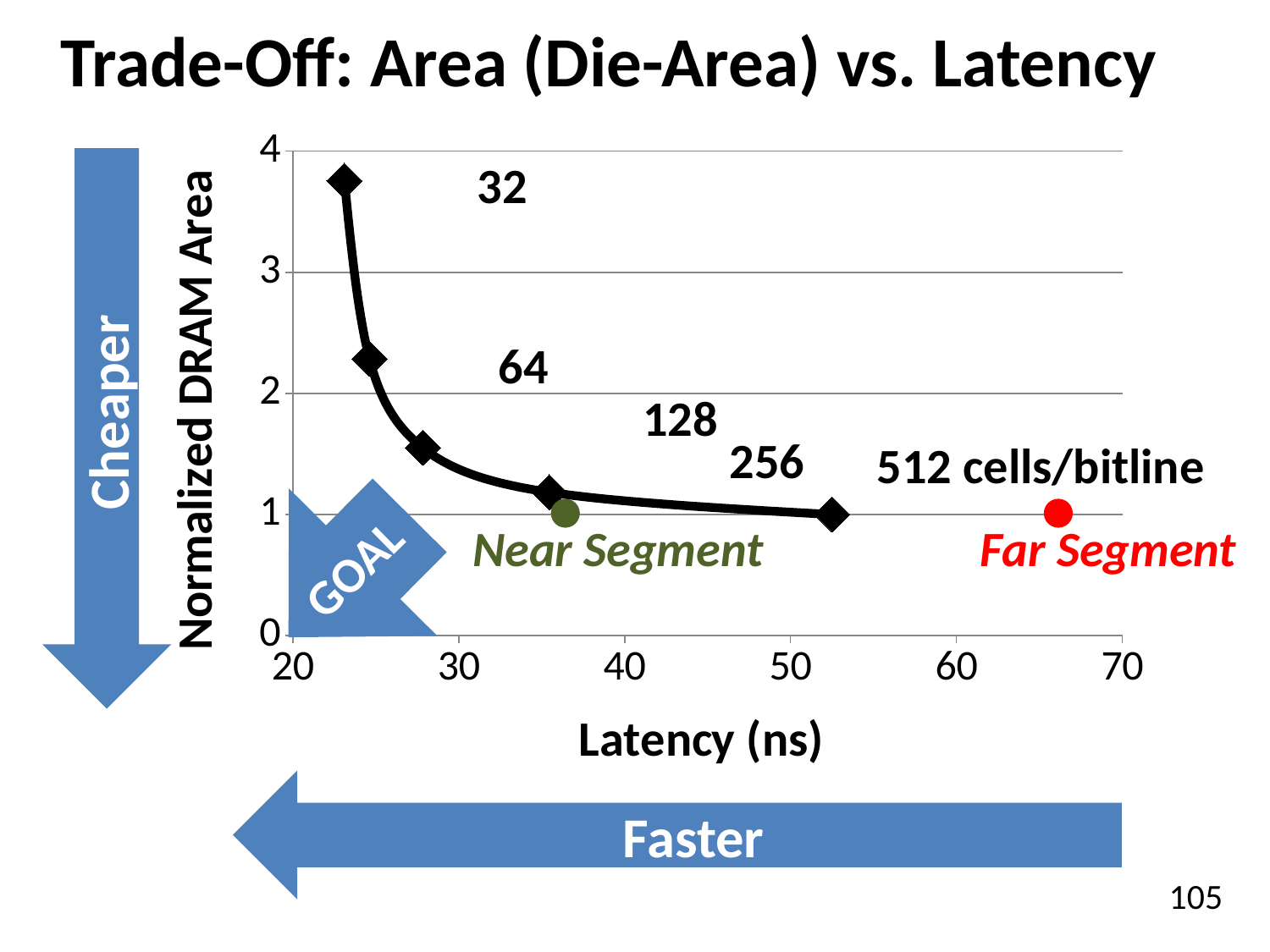
Is the normalized DRAM area for 128 cells/bitline greater or less than 2? less Is the normalized DRAM area for 32 cells/bitline greater or less than 3? greater Is the normalized DRAM area for 64 cells/bitline greater or less than 2? greater How many black diamond data points are plotted on the curve? 5 What kind of chart is shown on the slide? line chart Which cells/bitline configuration has the highest normalized DRAM area? 32 Which cells/bitline configuration has the lowest latency? 32 As latency increases along the x axis, does the normalized DRAM area rise or fall? fall What is the title of the x axis? Latency (ns)